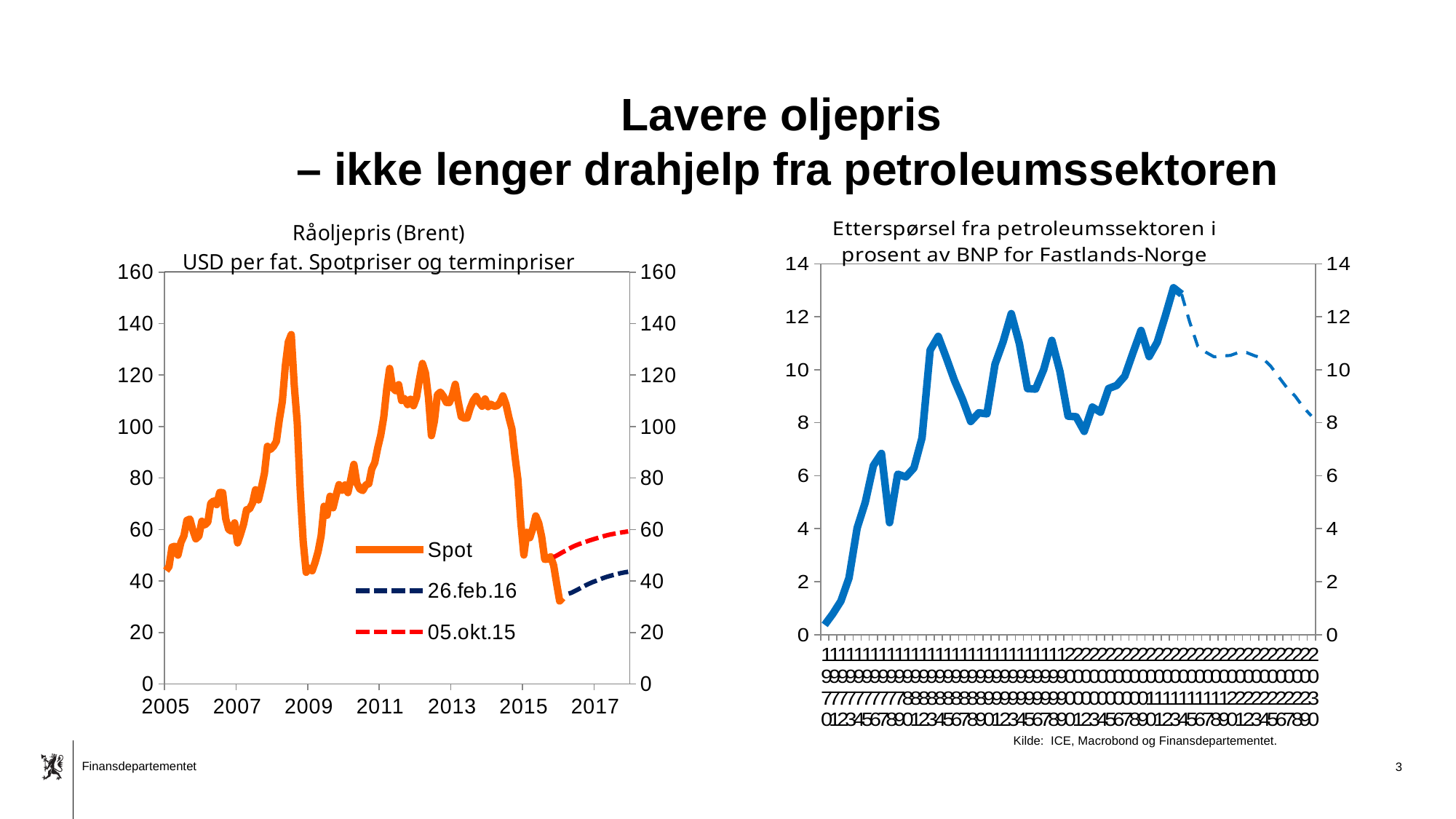
In the left chart, 'Råoljepris (Brent)', which of the two forward-price series is higher in 2017, 26.feb.16 or 05.okt.15? 05.okt.15 In the left chart, 'Råoljepris (Brent)', is the Spot value at the end of the series in early 2016 greater or less than 40? less In the right chart, 'Etterspørsel fra petroleumssektoren i prosent av BNP for Fastlands-Norge', is the value at the start of the series greater or less than 2? less In the left chart, 'Råoljepris (Brent)', does the Spot series rise or fall from mid-2014 to early 2016? fall In the right chart, 'Etterspørsel fra petroleumssektoren i prosent av BNP for Fastlands-Norge', is the highest value of the series greater or less than 12? greater In the right chart, 'Etterspørsel fra petroleumssektoren i prosent av BNP for Fastlands-Norge', does the dashed projection part of the line rise or fall towards the right end of the x axis? fall What kind of chart is the left chart, 'Råoljepris (Brent)'? line chart How many series does the legend of the left chart, 'Råoljepris (Brent)', list? 3 In the left chart, 'Råoljepris (Brent)', which series is drawn as a solid orange line? Spot What kind of chart is the right chart, 'Etterspørsel fra petroleumssektoren i prosent av BNP for Fastlands-Norge'? line chart